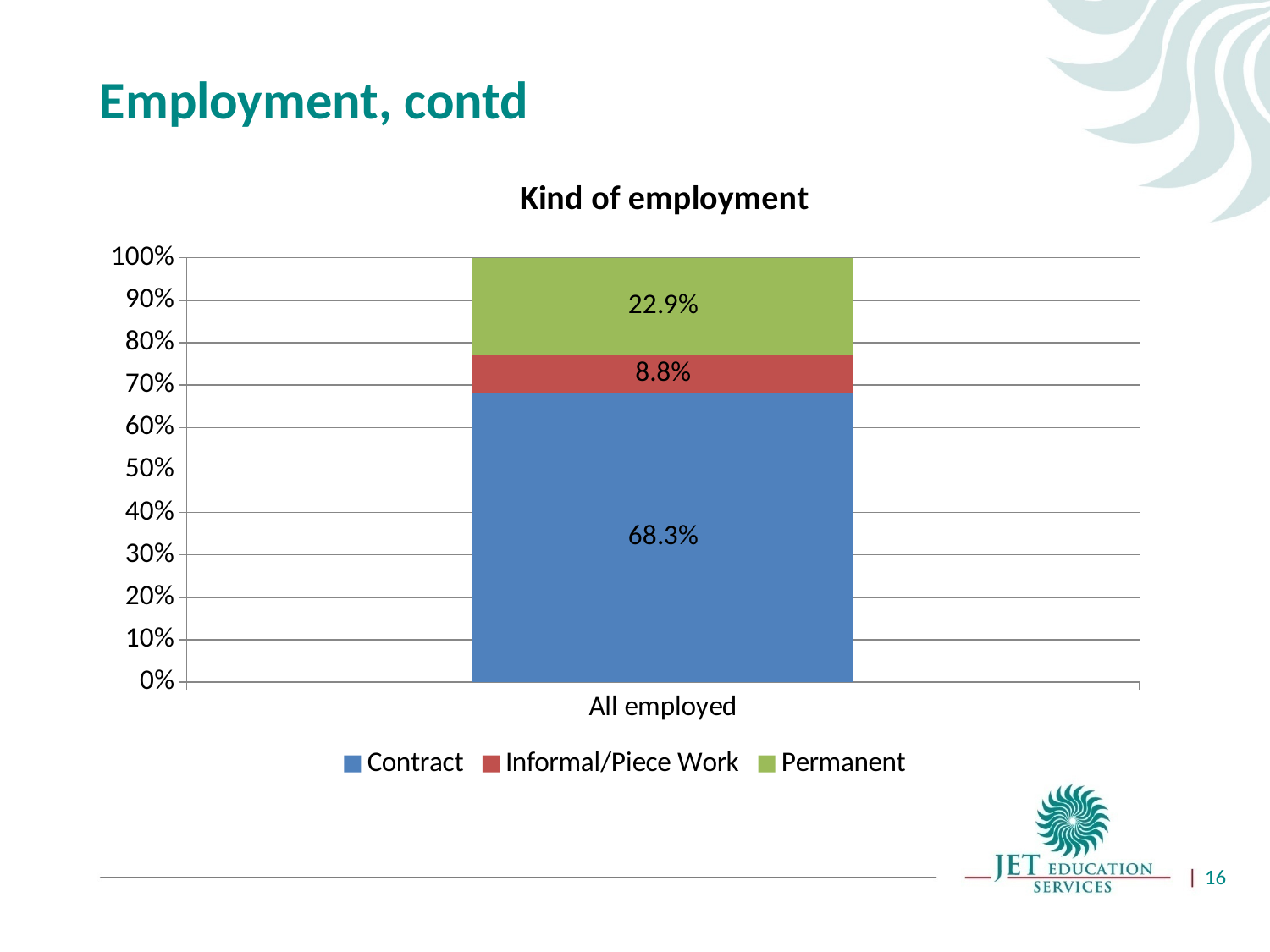
What is the value for Contract in the All employed bar? 68.3% What is the value for Informal/Piece Work in the All employed bar? 8.8% What is the difference between the Permanent and Informal/Piece Work values? 14.1% Which kind of employment has the lowest share in the All employed bar? Informal/Piece Work What kind of chart is shown on the slide? Stacked bar chart What is the value for Permanent in the All employed bar? 22.9% How many series does the legend list? 3 What is the difference between the Contract and Permanent values? 45.4% Which kind of employment has the highest share in the All employed bar? Contract What is the title of the chart? Kind of employment Which is larger, the Permanent value or the Informal/Piece Work value? Permanent What is the total of the All employed stacked bar? 100%